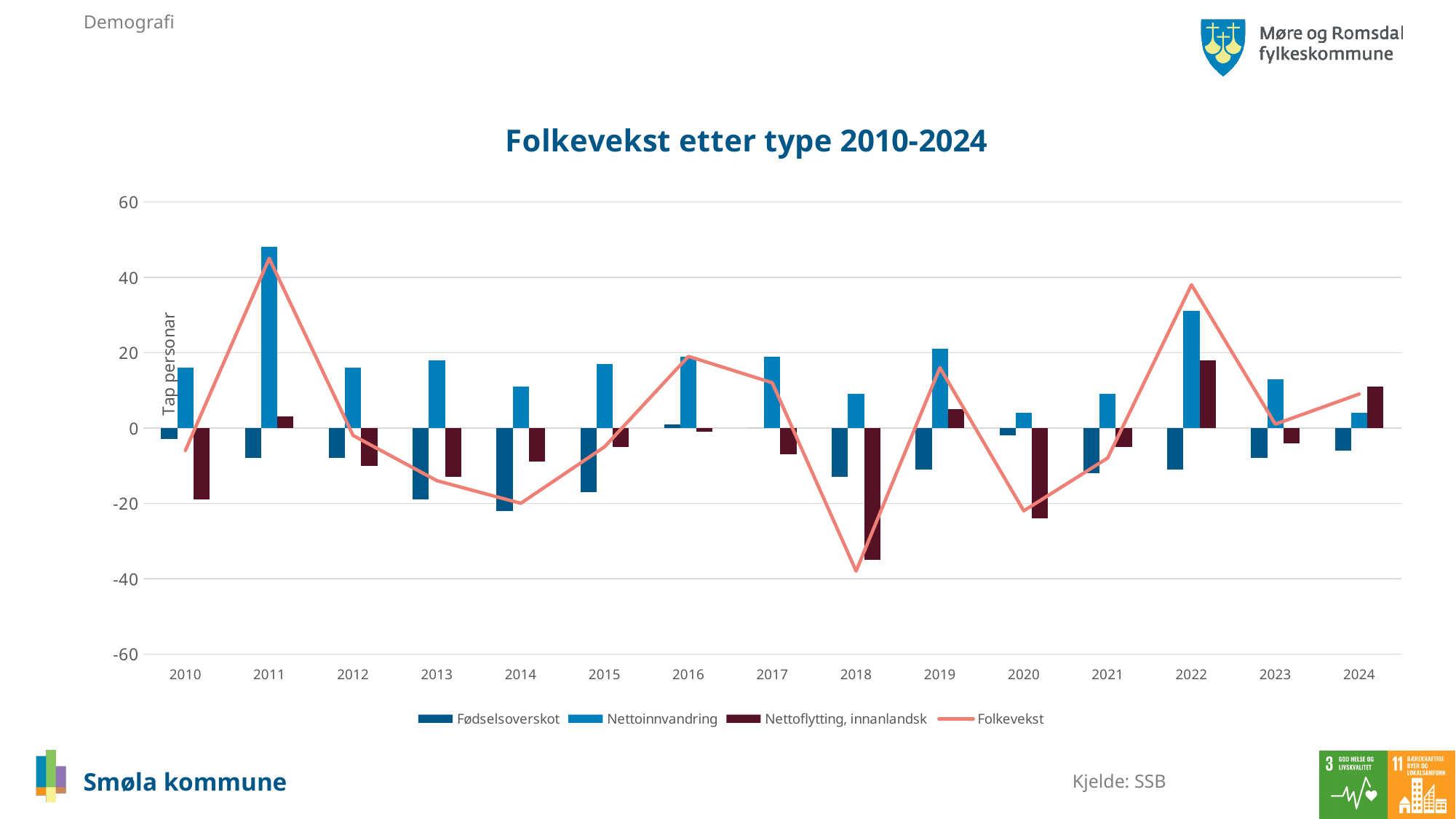
In which year does the Folkevekst line reach its lowest point? 2018 In which year does the Folkevekst line reach its highest point? 2011 What kind of chart is shown on the slide? A combined bar and line chart Is the Nettoinnvandring value for 2022 greater or less than 20? greater Is the Nettoflytting, innanlandsk value for 2018 greater or less than -20? less Is the Nettoinnvandring value for 2011 greater or less than 40? greater What is the title of the chart? Folkevekst etter type 2010-2024 In which year is the Nettoflytting, innanlandsk bar lowest? 2018 How many years are shown on the x axis? 15 In which year is the Nettoinnvandring bar highest? 2011 Which is larger, the Nettoinnvandring value for 2011 or for 2022? 2011 How many series does the legend list? 4